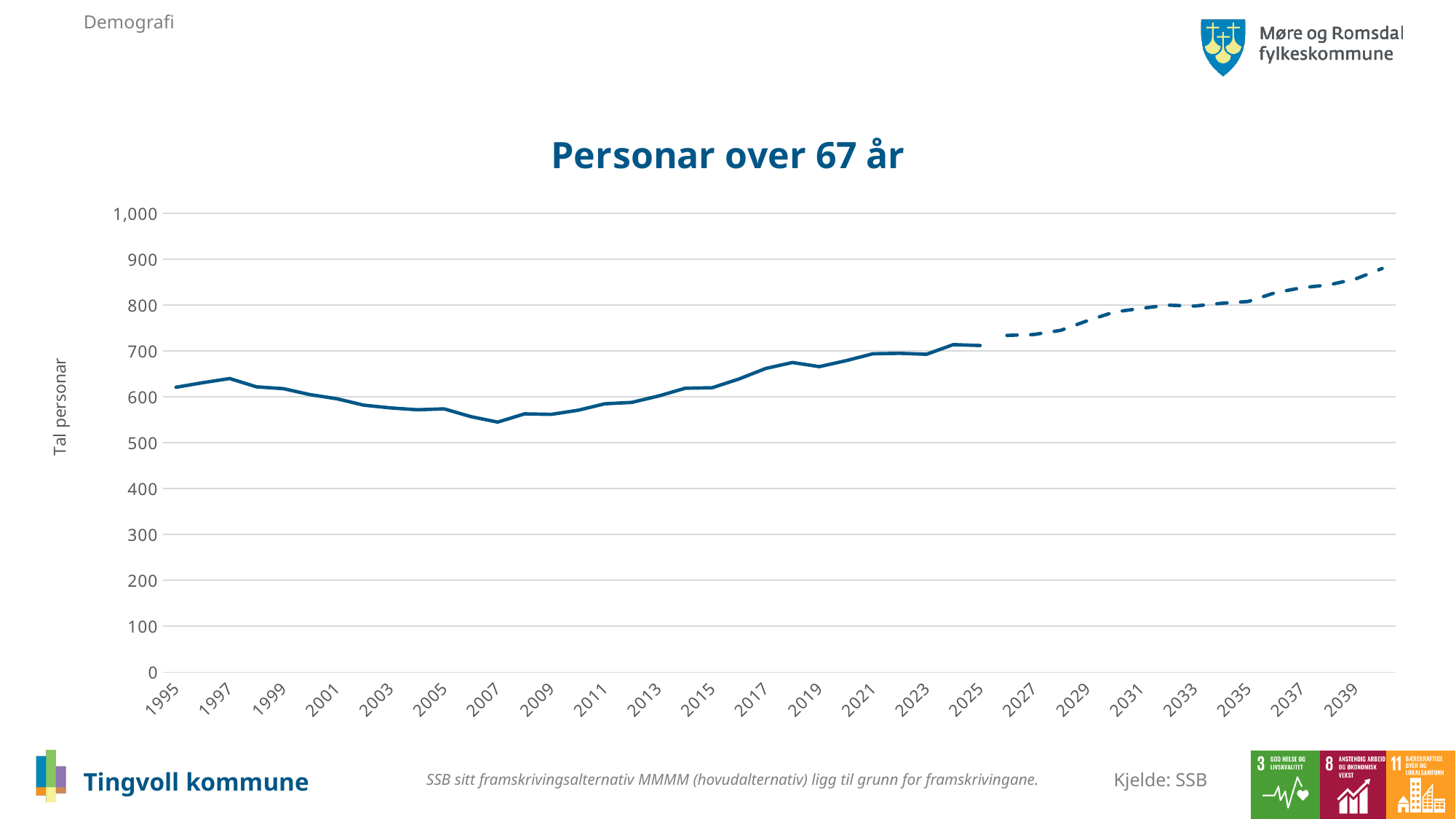
Is the value for 2025 greater or less than 700? greater Is the value for 2039 greater or less than 800? greater What kind of chart is shown on the slide? line chart Is the value for 2007 greater or less than 600? less What is the highest value shown on the vertical axis? 1,000 In which year does the line reach its lowest value? 2007 What is the label on the vertical axis of the chart? Tal personar Which year has the higher value, 1997 or 2007? 1997 What is the title of the chart? Personar over 67 år Does the line rise or fall between 2007 and 2025? rise